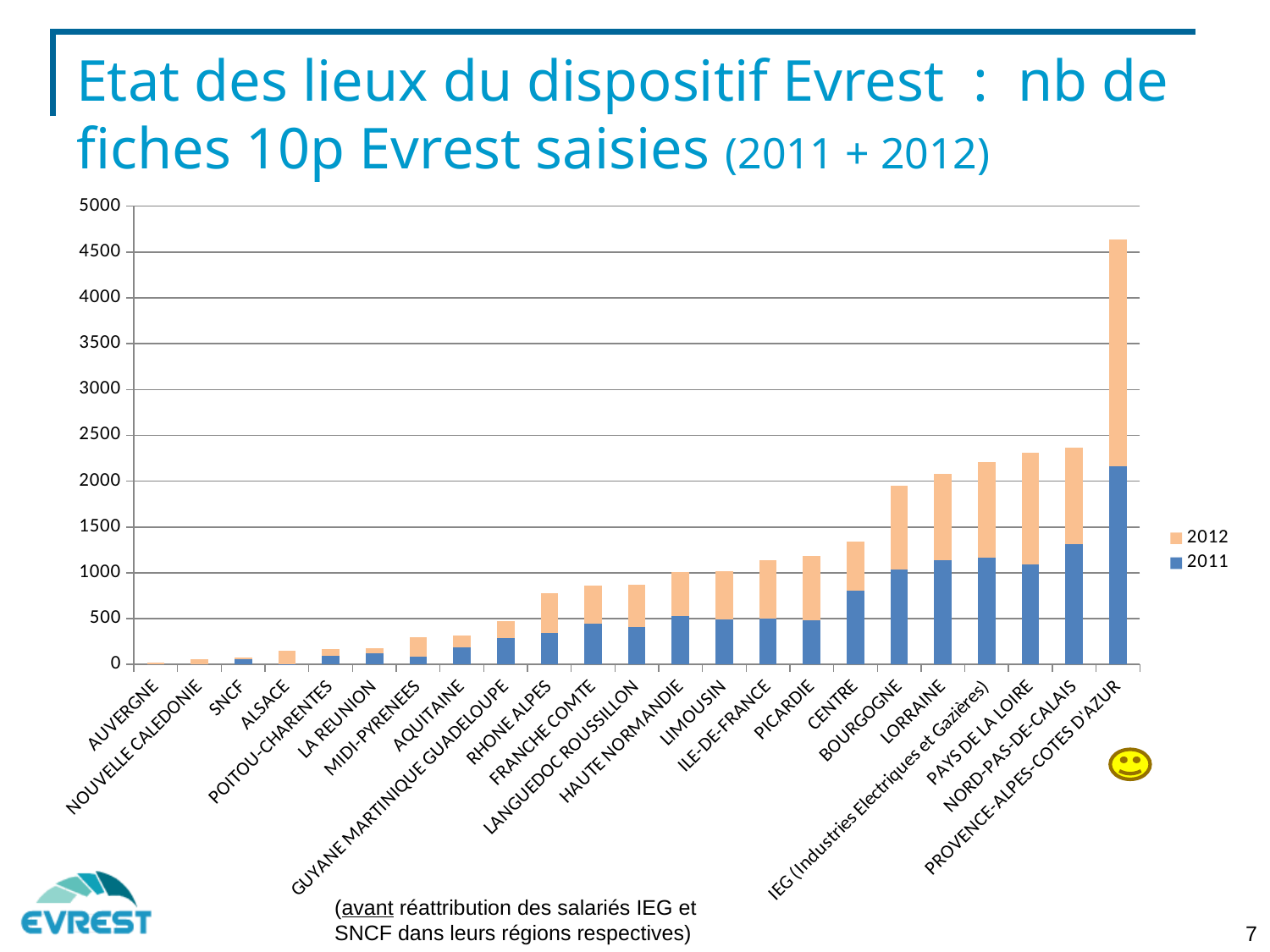
How many categories are shown on the x axis? 23 Is the 2011 value for PROVENCE-ALPES-COTES D'AZUR greater or less than 2000? greater Which has the larger total, CENTRE or PICARDIE? CENTRE Is the total value for CENTRE greater or less than 1000? greater Do the total values generally rise or fall from left to right along the x axis? rise Which two series are listed in the legend? 2012 and 2011 Is the total value for BOURGOGNE greater or less than 1500? greater How many series does the legend list? 2 What kind of chart is shown on the slide? Stacked bar chart Which category has the lowest total number of fiches? AUVERGNE Which category has the highest total number of fiches? PROVENCE-ALPES-COTES D'AZUR